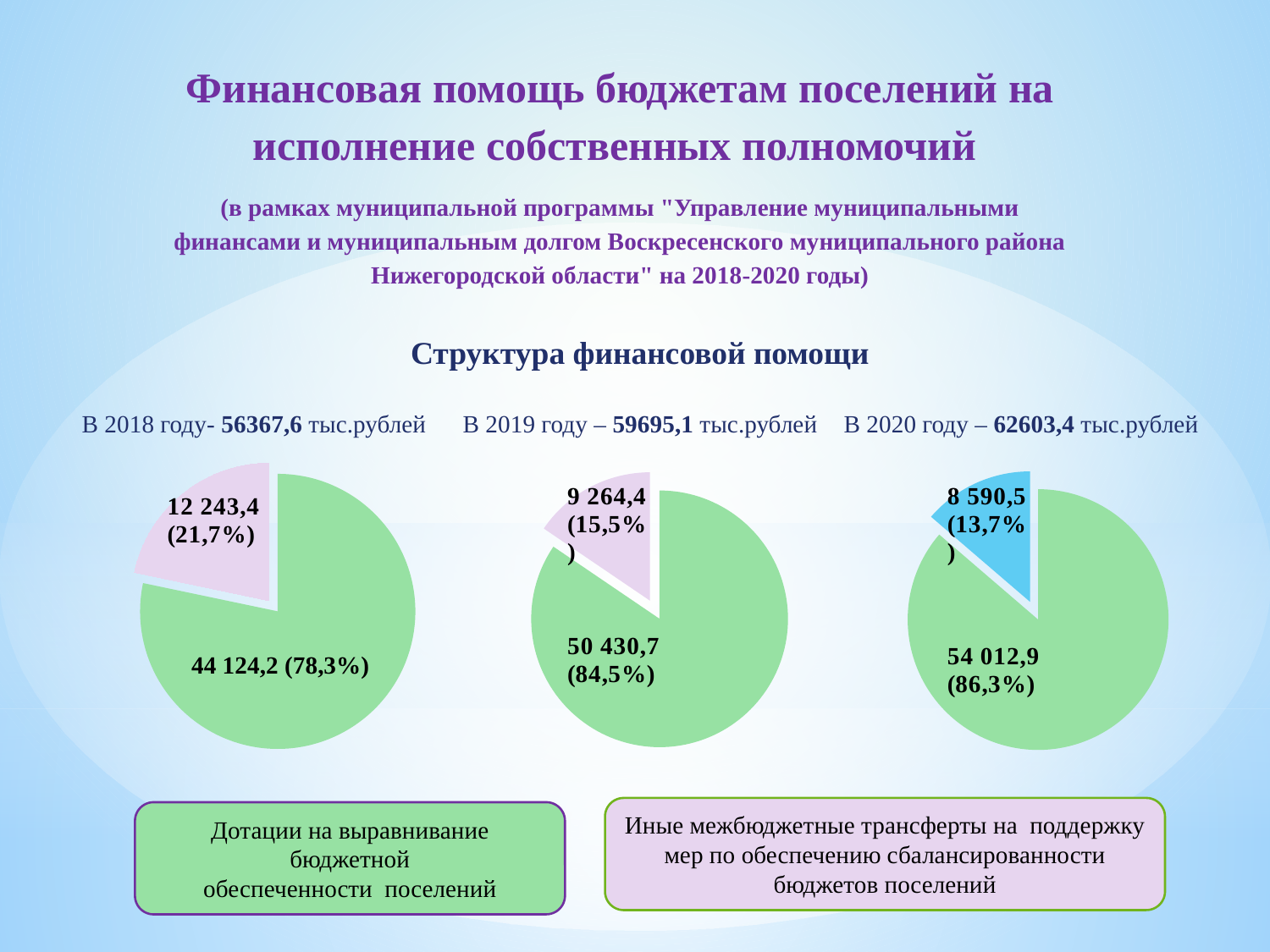
In the 2020 pie chart, what is the value for Дотации на выравнивание бюджетной обеспеченности поселений? 54 012,9 In the 2019 pie chart, what share do Дотации на выравнивание бюджетной обеспеченности поселений make up? 84,5% In the 2018 pie chart, which is larger: Дотации на выравнивание or Иные межбюджетные трансферты? Дотации на выравнивание In the 2019 pie chart, what is the value for Иные межбюджетные трансферты? 9 264,4 In the 2018 pie chart, what is the difference between the Дотации value and the Иные межбюджетные трансферты value? 31 880,8 How many slices does each pie chart have? 2 In the 2018 pie chart, what share do Иные межбюджетные трансферты make up? 21,7% In the 2018 pie chart, what is the value for Дотации на выравнивание бюджетной обеспеченности поселений? 44 124,2 In the 2020 pie chart, what share do Иные межбюджетные трансферты make up? 13,7% Across the 2018, 2019 and 2020 pie charts, does the share of Иные межбюджетные трансферты rise or fall? Fall Which year's pie chart shows the largest value for Дотации на выравнивание бюджетной обеспеченности поселений? 2020 What kind of charts are shown on the slide? Pie charts